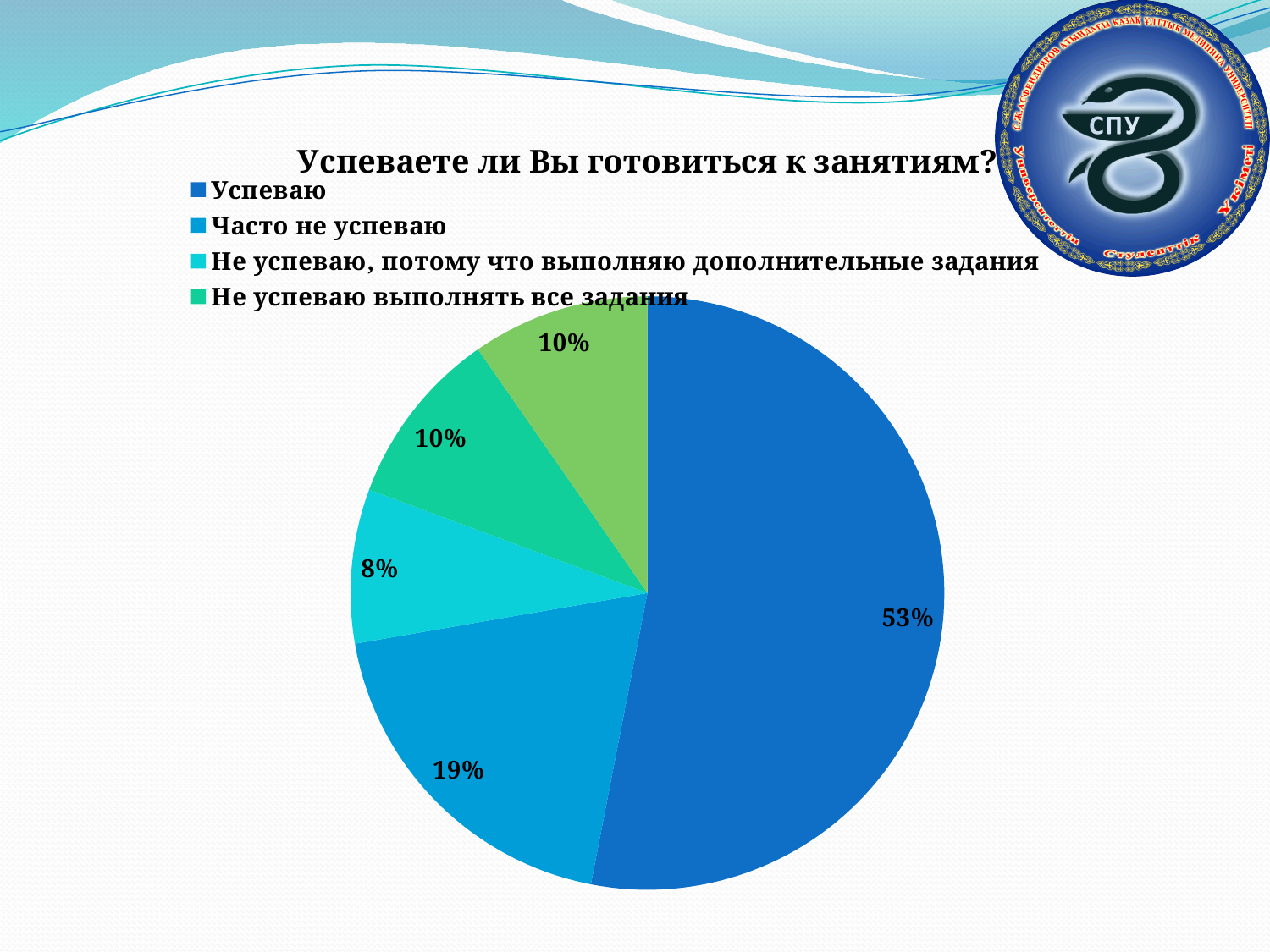
Which category has the largest share of the pie? Успеваю What is the title of the chart? Успеваете ли Вы готовиться к занятиям? What percentage of the pie corresponds to "Часто не успеваю"? 19% Which is larger: the share for "Часто не успеваю" or the share for "Не успеваю выполнять все задания"? Часто не успеваю What percentage of the pie corresponds to "Успеваю"? 53% How many percentage points larger is the "Успеваю" slice than the "Часто не успеваю" slice? 34 What kind of chart is shown on the slide? pie chart How many entries does the legend list? 4 How many slices does the pie chart have? 5 What percentage of the pie corresponds to "Не успеваю, потому что выполняю дополнительные задания"? 8% Which legend category has the smallest share of the pie? Не успеваю, потому что выполняю дополнительные задания What percentage of the pie corresponds to "Не успеваю выполнять все задания"? 10%